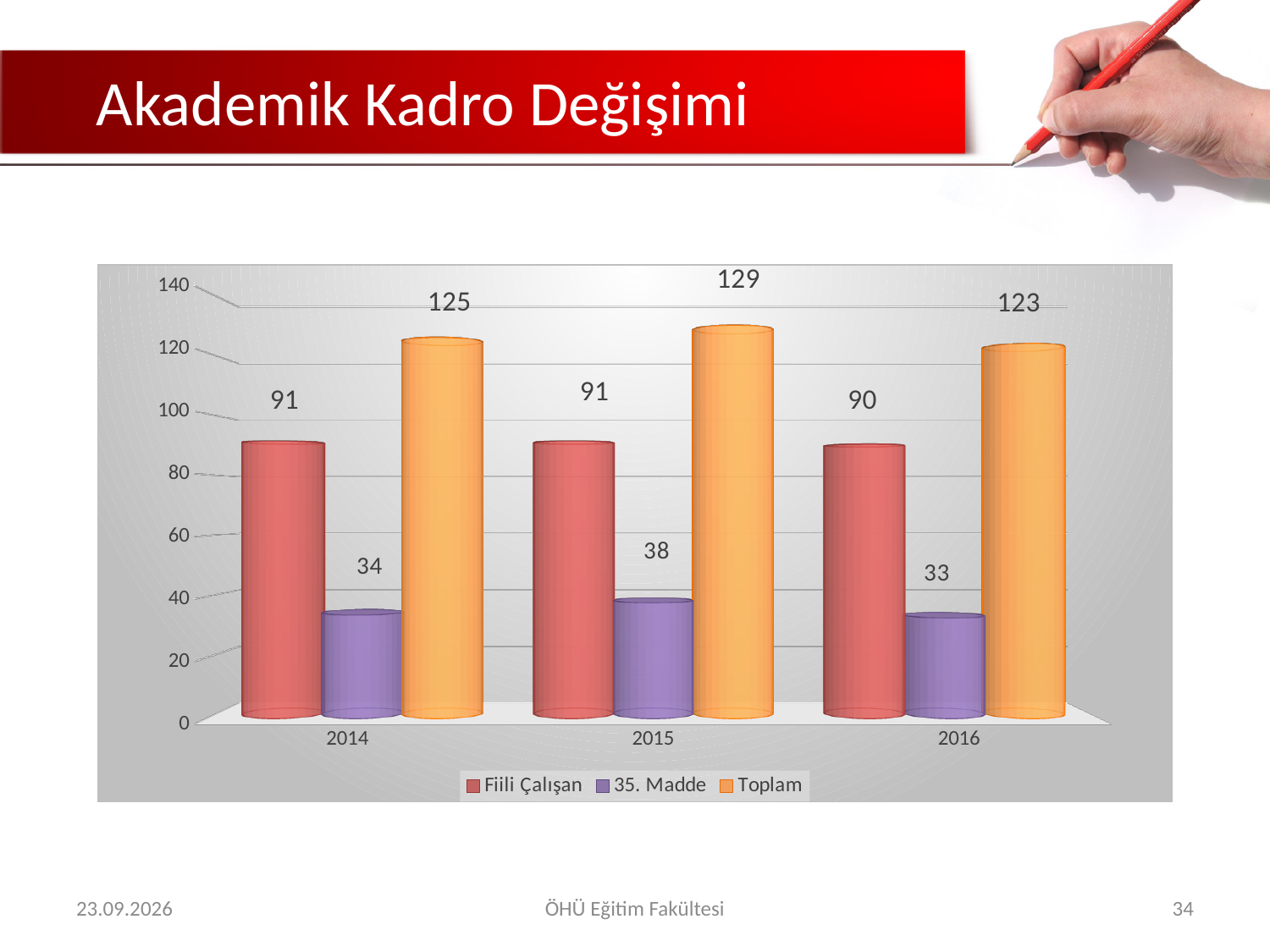
What is the value of 35. Madde for 2014? 34 In which year is Toplam highest? 2015 How many series does the legend list? 3 What is the difference between 35. Madde in 2015 and 35. Madde in 2016? 5 What is the value of Toplam for 2015? 129 What is the difference between Toplam and Fiili Çalışan in 2014? 34 In which year is 35. Madde lowest? 2016 Which is larger, Fiili Çalışan in 2015 or Fiili Çalışan in 2016? Fiili Çalışan in 2015 What is the title of the slide containing the chart? Akademik Kadro Değişimi What kind of chart is shown on the slide? Bar chart How many years are shown on the x axis? 3 What is the value of Fiili Çalışan for 2016? 90